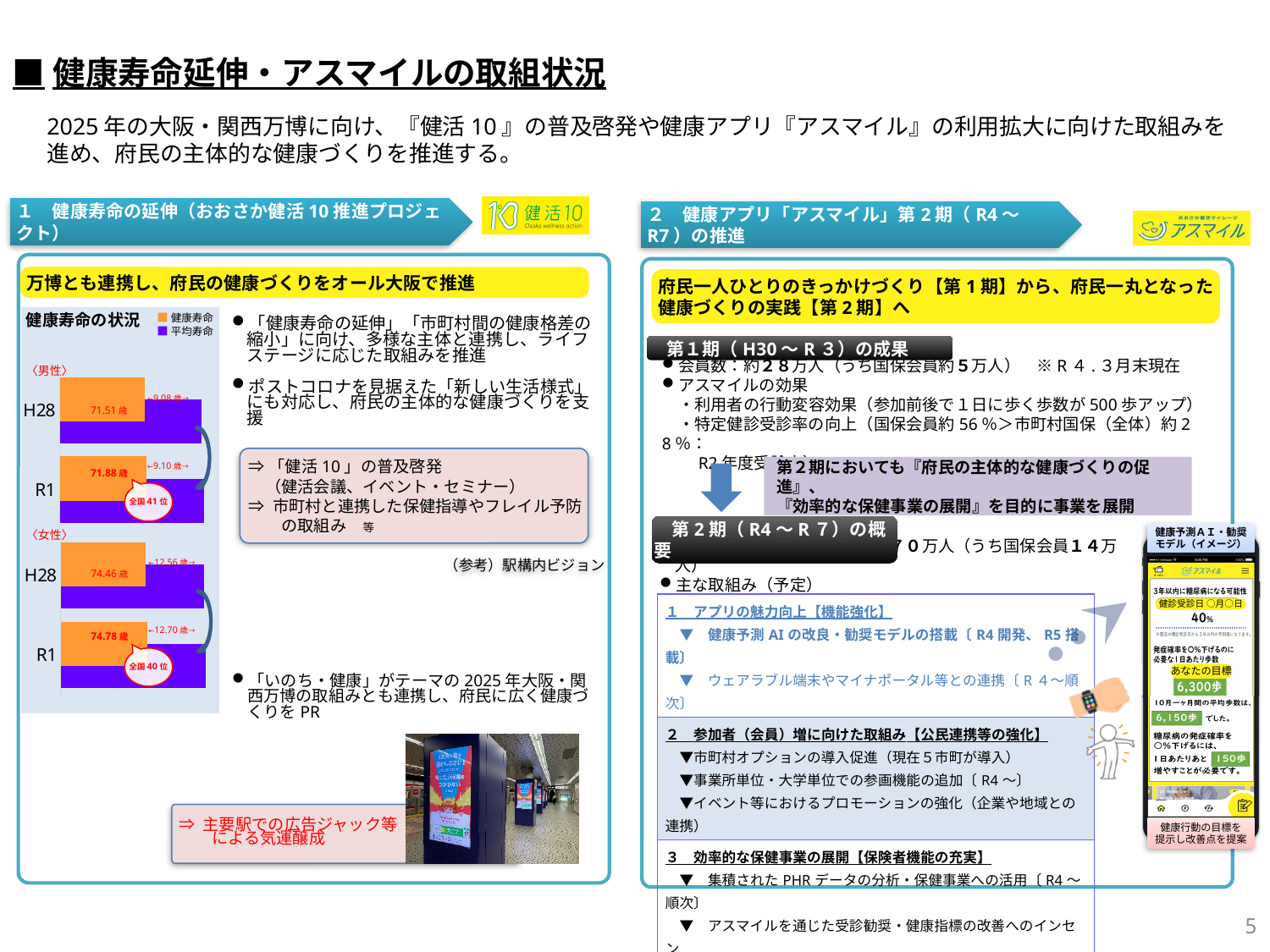
How many series does the legend of the 健康寿命の状況 chart list? 2 In the 健康寿命の状況 chart, what is the gap between 健康寿命 and 平均寿命 shown for 女性 in R1? 12.70歳 In the 健康寿命の状況 chart, by how much did the 男性 健康寿命 increase from H28 to R1? 0.37歳 In the 健康寿命の状況 chart, what is the 健康寿命 value for 男性 in H28? 71.51歳 What kind of chart is the 健康寿命の状況 chart? bar chart In the 健康寿命の状況 chart, what is the 健康寿命 value for 女性 in H28? 74.46歳 In the 健康寿命の状況 chart, what is the 健康寿命 value for 女性 in R1? 74.78歳 In the 健康寿命の状況 chart, which legend entry is shown in orange? 健康寿命 In the 健康寿命の状況 chart, by how much did the 女性 健康寿命 increase from H28 to R1? 0.32歳 In the 健康寿命の状況 chart, what is the gap between 健康寿命 and 平均寿命 shown for 男性 in H28? 9.08歳 In the 健康寿命の状況 chart, what is the 健康寿命 value for 男性 in R1? 71.88歳 In the 健康寿命の状況 chart, which is larger in R1: the 健康寿命 for 男性 or for 女性? 女性